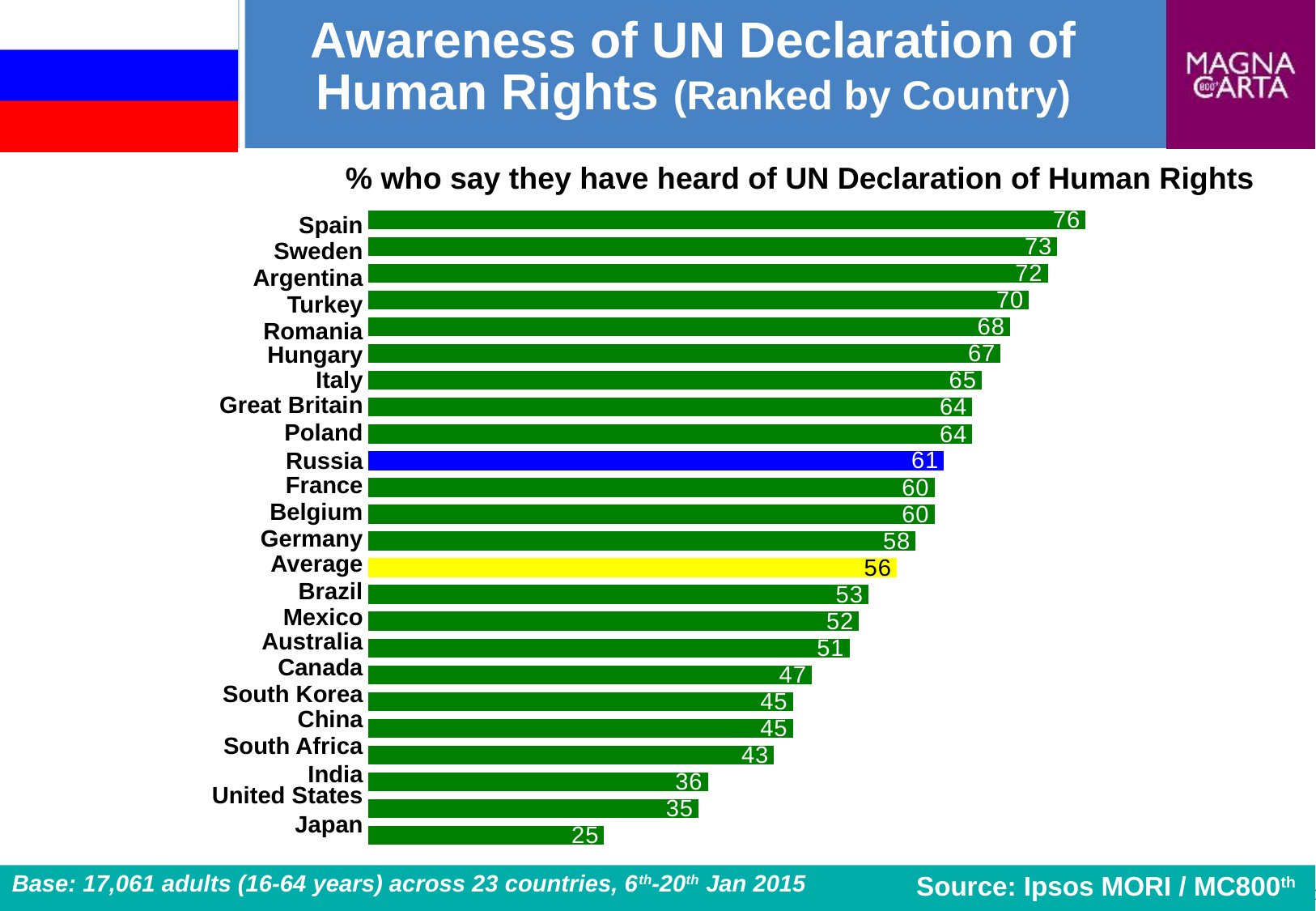
What is the value for Japan? 25 Which country has the lowest value? Japan Which country has the highest value? Spain What is the value shown for Average? 56 Which has a larger value, Germany or Brazil? Germany What is the difference between the values for Spain and Japan? 51 How many bars are shown in the chart, including the Average? 24 What is the difference between the values for Russia and the Average? 5 What kind of chart is shown on the slide? Bar chart Which has a larger value, United States or India? India Which bar is coloured blue? Russia What is the value for Russia? 61